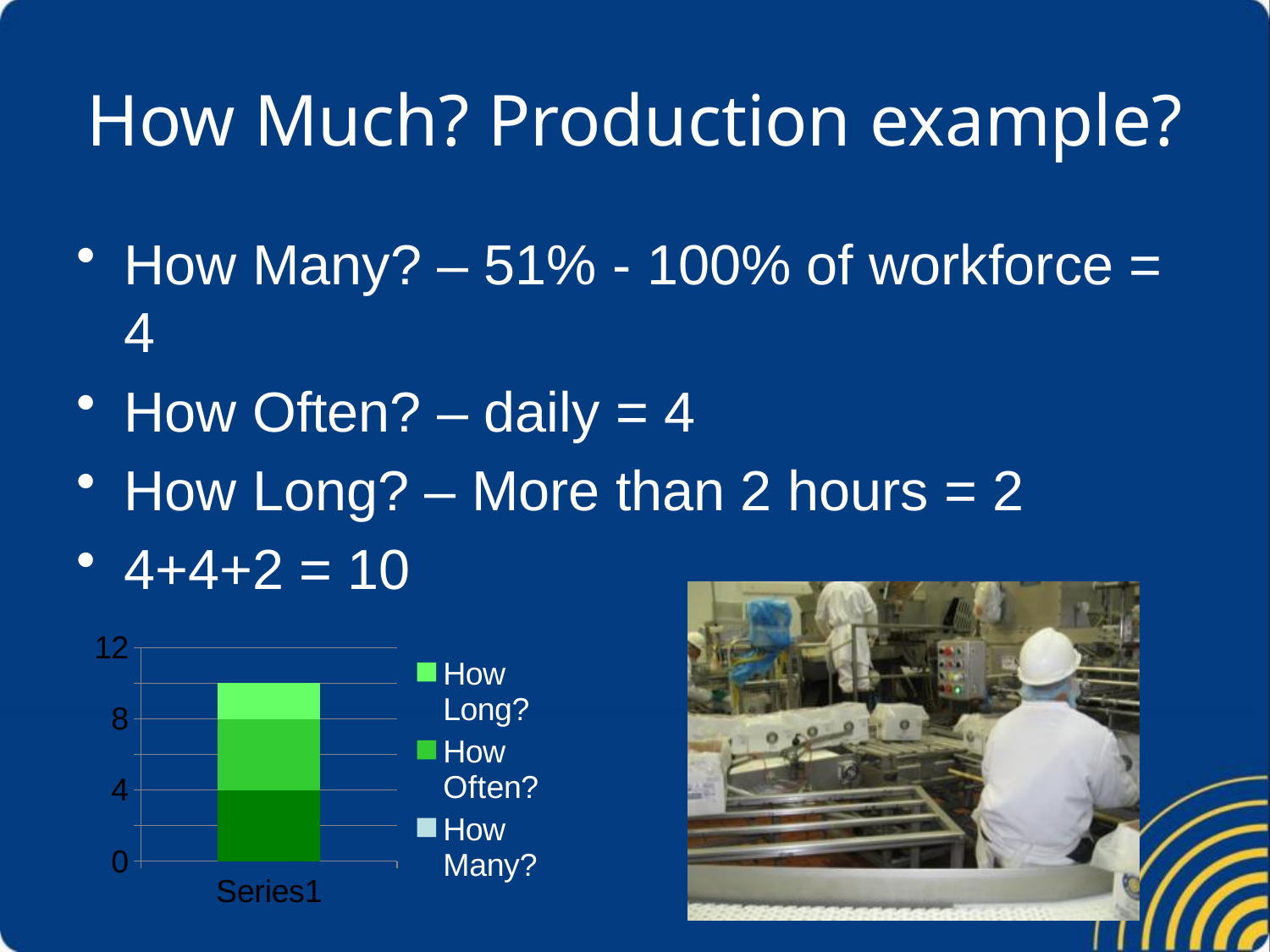
Which series is shown at the bottom of the stacked bar? How Many? What is the highest value shown on the chart's vertical axis? 12 Which series has the smallest segment in the stacked bar? How Long? What is the value of the How Many? segment in the stacked bar? 4 Is the total height of the Series1 stacked bar greater or less than 8? greater What is the label of the category on the x axis of the chart? Series1 What kind of chart is shown on the slide? bar chart What is the total of the Series1 stacked bar? 10 Is the total height of the Series1 stacked bar greater or less than 12? less How many categories are plotted on the x axis of the chart? 1 How many series does the chart legend list? 3 Which segment is larger in the stacked bar, How Many? or How Long? How Many?